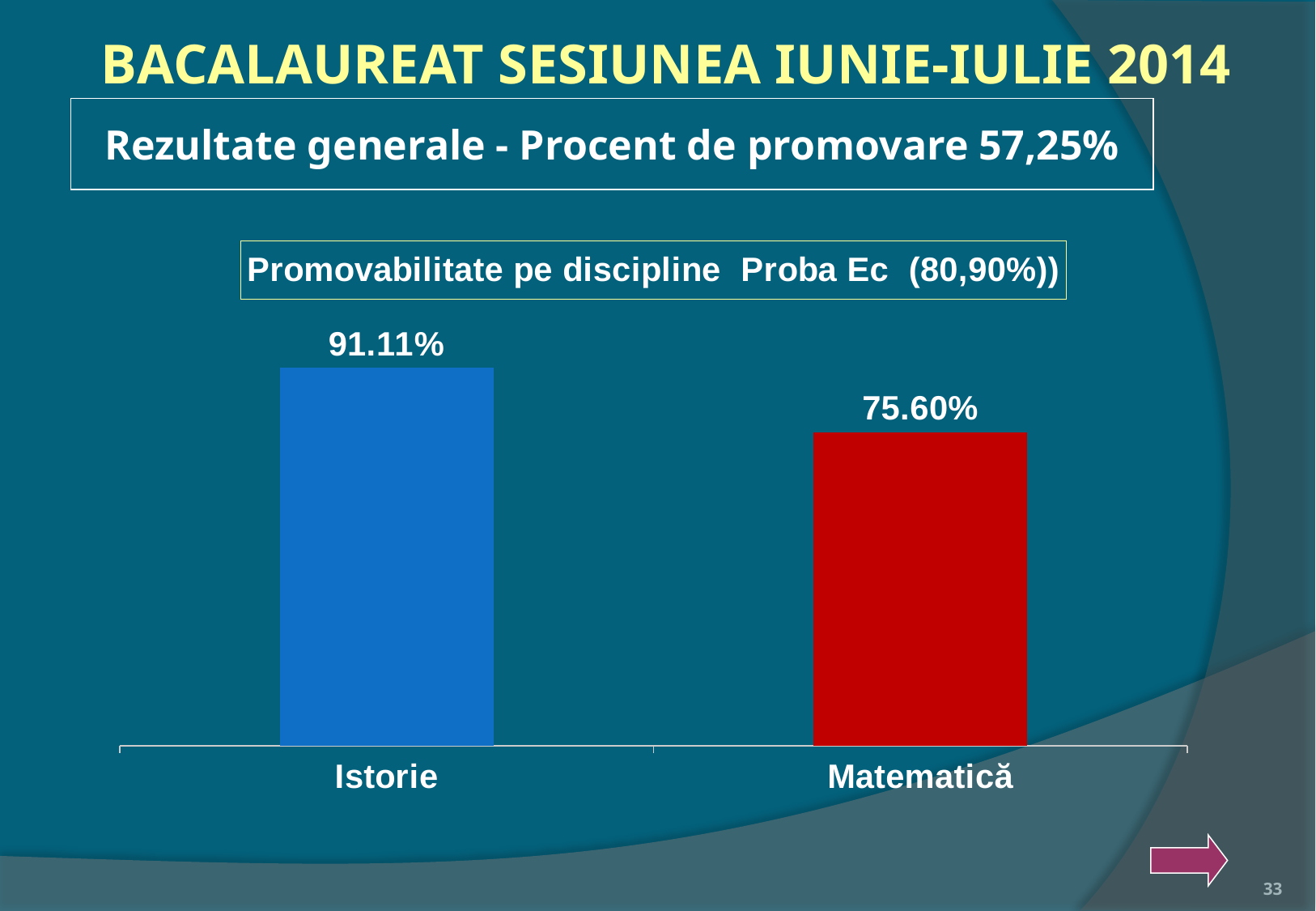
What is the title of the chart? Promovabilitate pe discipline Proba Ec (80,90%)) What is the value for Istorie? 91.11% What is the value for Matematică? 75.60% What kind of chart is shown on the slide? Bar chart How many categories are shown in the chart? 2 What is the difference between the values for Istorie and Matematică? 15.51% What colour is the bar for Matematică? Red Which is larger, the value for Istorie or the value for Matematică? Istorie Do the values rise or fall from Istorie to Matematică? Fall Which category has the lowest value? Matematică Which category has the highest value? Istorie